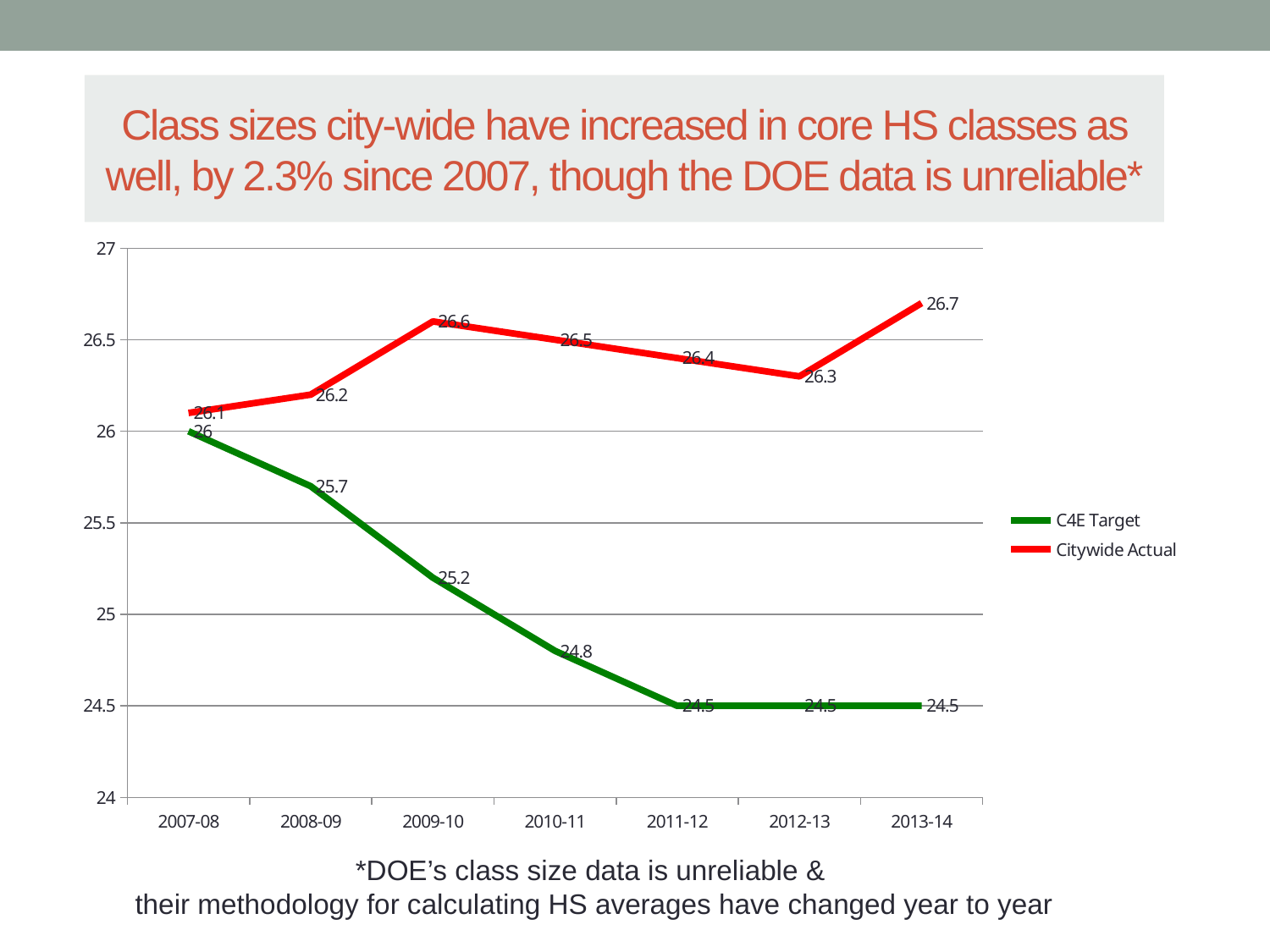
Does the C4E Target series rise or fall from 2007-08 to 2011-12? Fall In which year is the C4E Target value highest? 2007-08 What is the Citywide Actual value for 2013-14? 26.7 How many series does the legend list? 2 Which is larger in 2010-11, the Citywide Actual value or the C4E Target value? Citywide Actual What colour is the line for Citywide Actual? Red What is the difference between the Citywide Actual and C4E Target values in 2013-14? 2.2 In which year is the Citywide Actual value highest? 2013-14 How many years are shown on the x axis? 7 What is the C4E Target value for 2009-10? 25.2 What is the Citywide Actual value for 2007-08? 26.1 What kind of chart is shown on the slide? Line chart